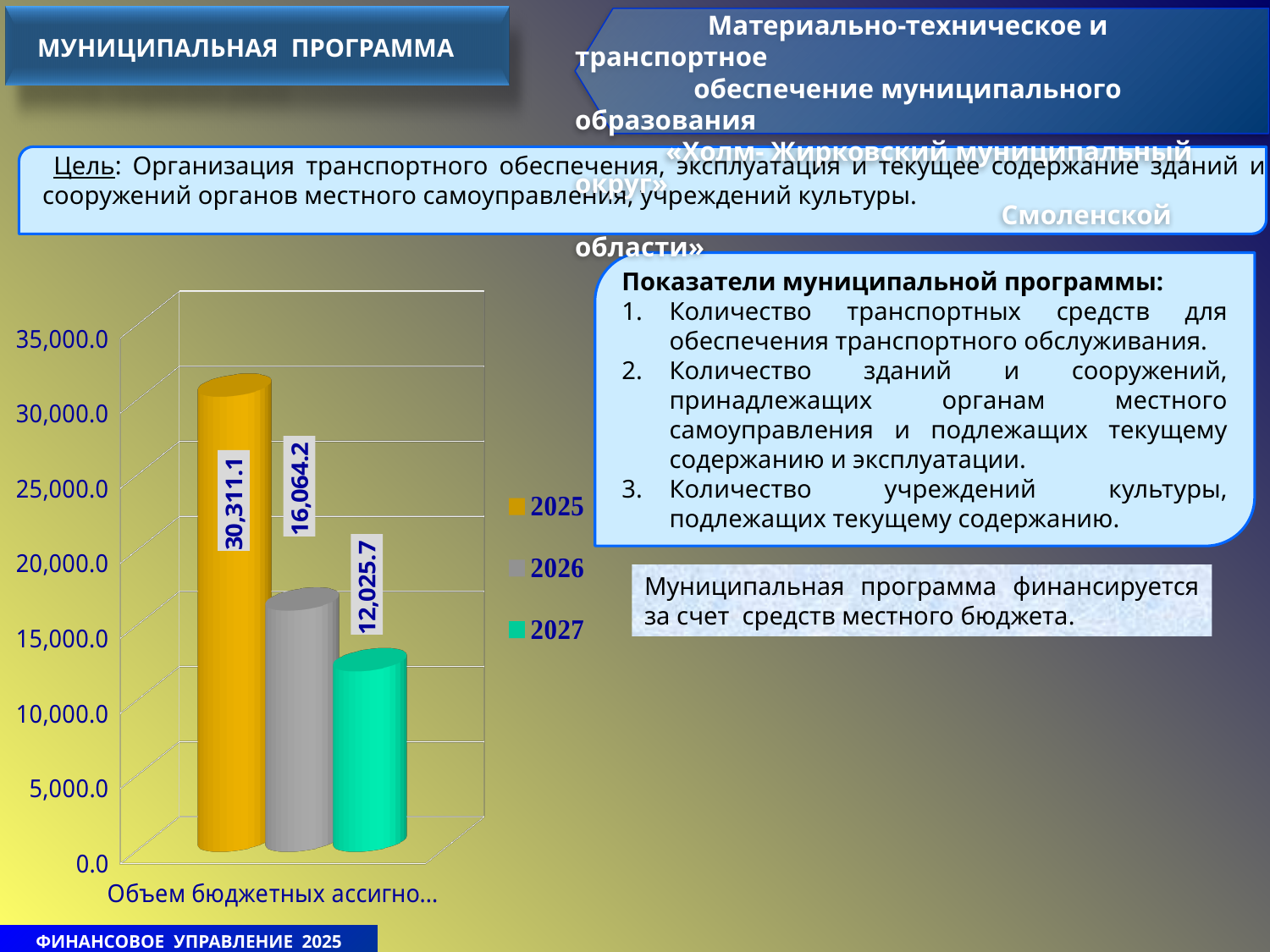
What is the value for the 2026 series in the chart? 16,064.2 What kind of chart is shown on the slide? bar chart What is the value for the 2025 series in the chart? 30,311.1 How many series does the legend list? 3 Is the value for 2025 greater or less than 25,000.0? greater Which series has the lowest value in the chart? 2027 What is the value for the 2027 series in the chart? 12,025.7 Which is larger, the value for 2026 or the value for 2027? 2026 What colour is the bar for the 2027 series? green Which series has the highest value in the chart? 2025 What is the difference between the 2025 value and the 2026 value? 14,246.9 What is the difference between the 2026 value and the 2027 value? 4,038.5